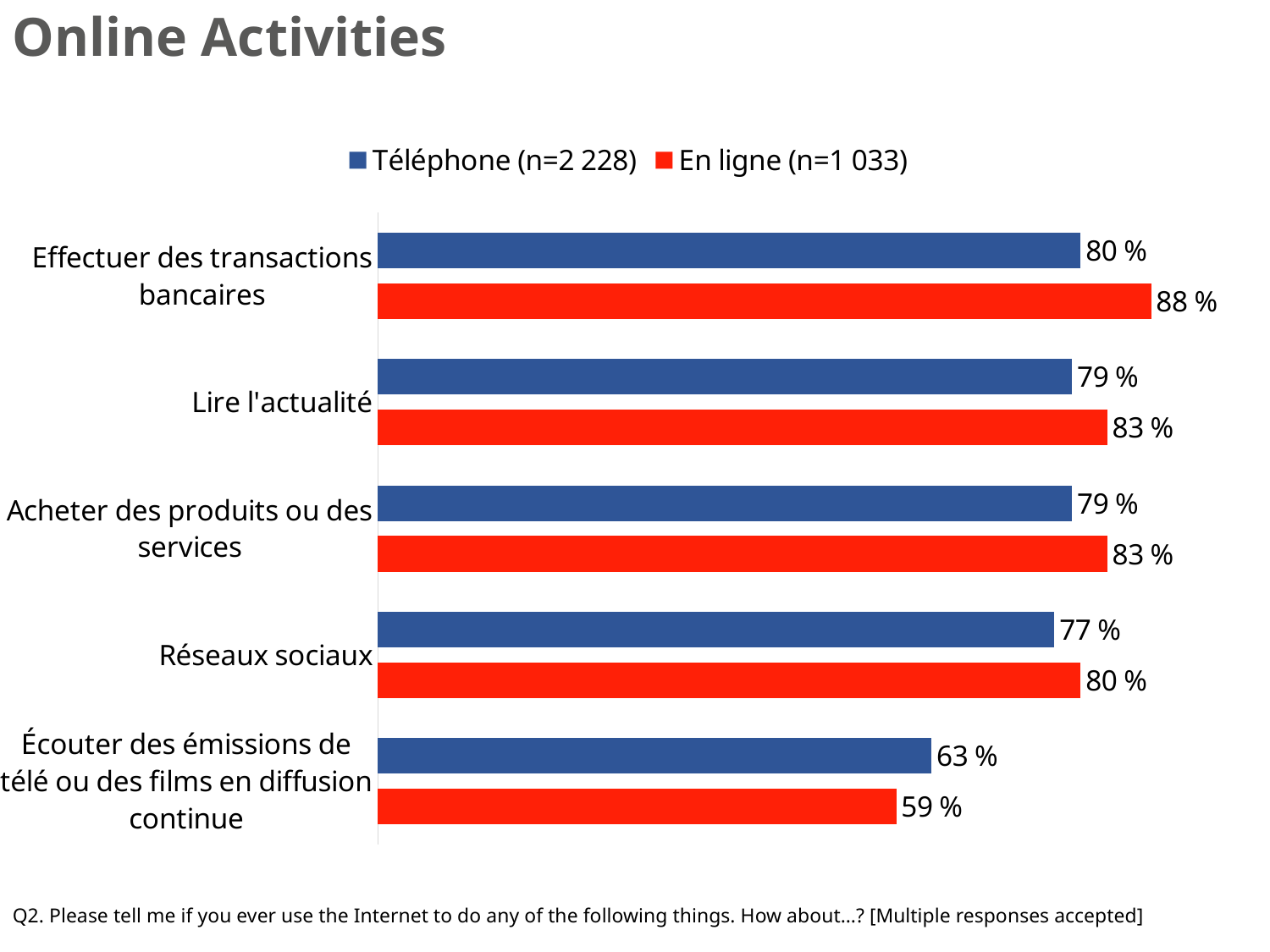
What is the En ligne value for Réseaux sociaux? 80 % For Écouter des émissions de télé ou des films en diffusion continue, which is larger: the Téléphone value or the En ligne value? Téléphone For Lire l'actualité, which is larger: the Téléphone value or the En ligne value? En ligne Which category has the lowest Téléphone value? Écouter des émissions de télé ou des films en diffusion continue Which category has the highest En ligne value? Effectuer des transactions bancaires What is the Téléphone value for Effectuer des transactions bancaires? 80 % What is the En ligne value for Écouter des émissions de télé ou des films en diffusion continue? 59 % What kind of chart is shown on the slide? Bar chart How many categories are shown on the chart? 5 What is the difference between the En ligne and Téléphone values for Effectuer des transactions bancaires? 8 % What is the difference between the Téléphone and En ligne values for Écouter des émissions de télé ou des films en diffusion continue? 4 % How many series does the legend list? 2